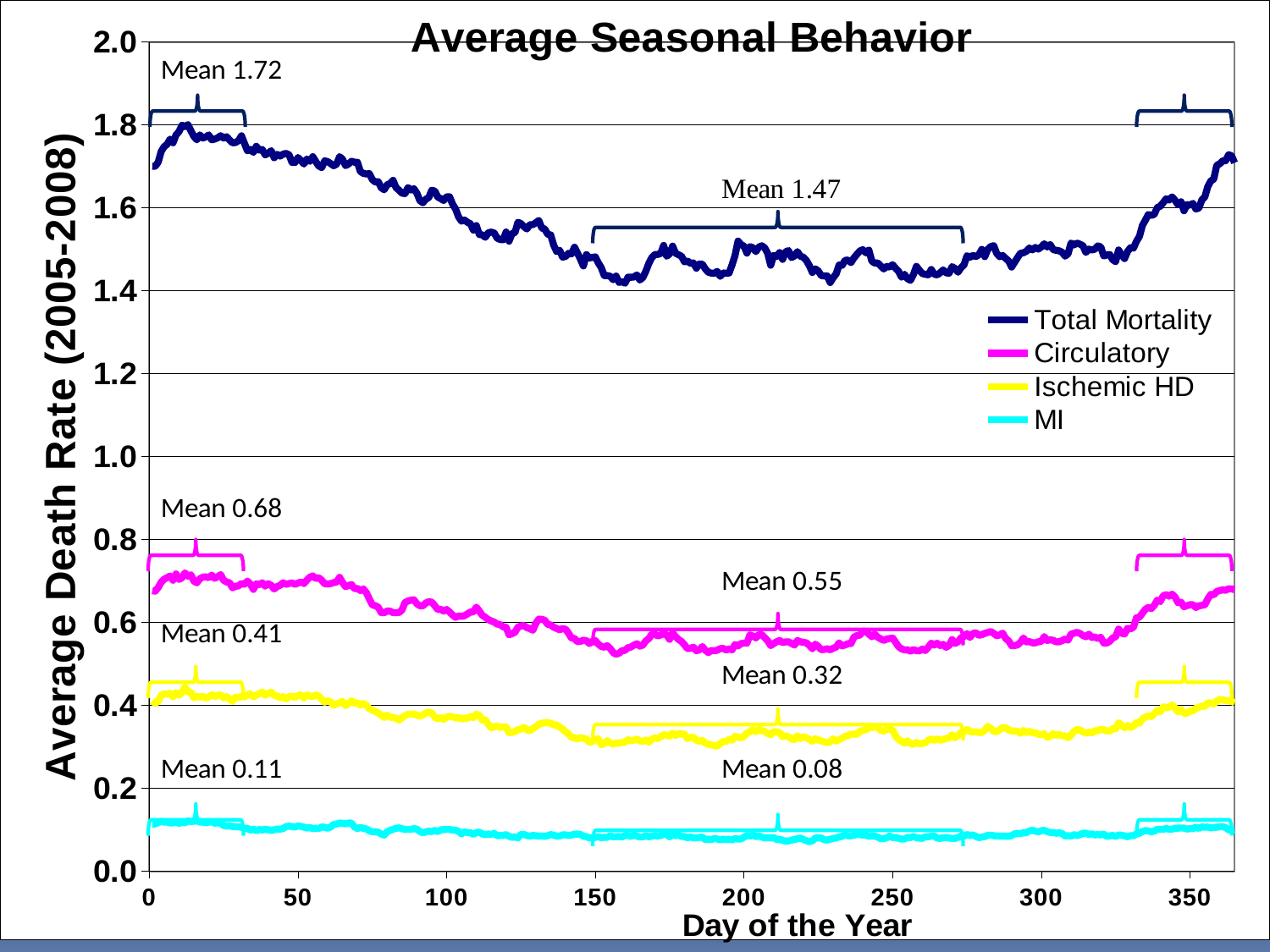
What kind of chart is shown on the slide? line chart Is the Total Mortality value at day 200 greater or less than 1.6? less What is the label of the x axis? Day of the Year What is the early-year mean annotated for Ischemic HD? 0.41 What is the mid-year mean annotated for MI? 0.08 What is the mid-year mean annotated for Circulatory? 0.55 What is the winter (early-year) mean annotated for Total Mortality? 1.72 How many series does the legend list? 4 What is the title of the chart? Average Seasonal Behavior Which series has the highest values throughout the year? Total Mortality What is the difference between the two annotated means for Total Mortality (1.72 and 1.47)? 0.25 Which series has the lowest values throughout the year? MI